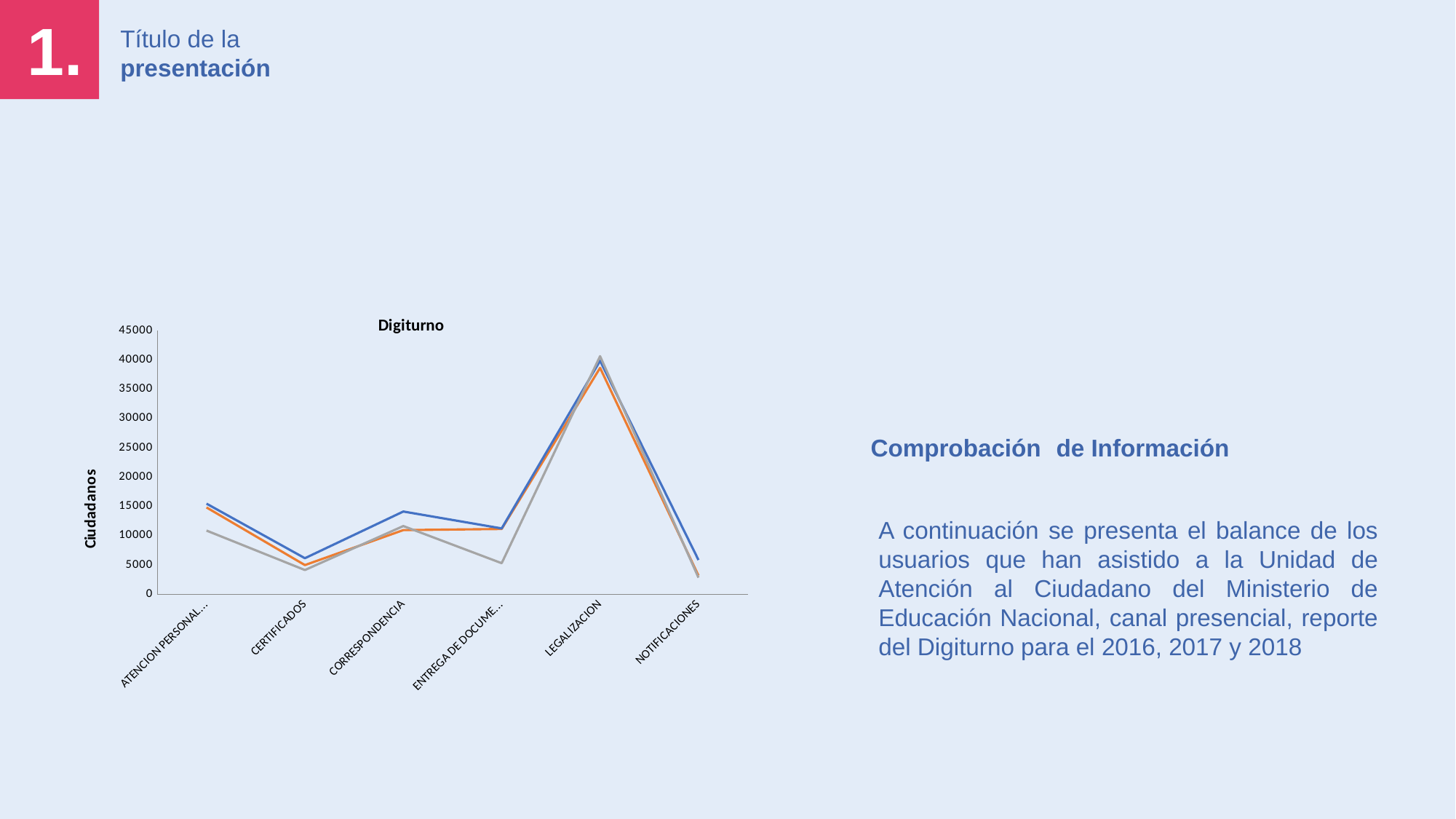
For the blue line, which is larger: the value for LEGALIZACION or the value for CORRESPONDENCIA? LEGALIZACION What is the title of the chart? Digiturno Is the value of the blue line for CERTIFICADOS greater or less than 10000? less Is the value of the blue line for LEGALIZACION greater or less than 35000? greater Is the value of the blue line for CORRESPONDENCIA greater or less than 10000? greater Which category has the highest values on the chart? LEGALIZACION What is the label on the vertical axis of the chart? Ciudadanos What kind of chart is shown on the slide? line chart How many categories are shown along the x axis of the chart? 6 Do the lines rise or fall from LEGALIZACION to NOTIFICACIONES? fall How many lines are plotted on the chart? 3